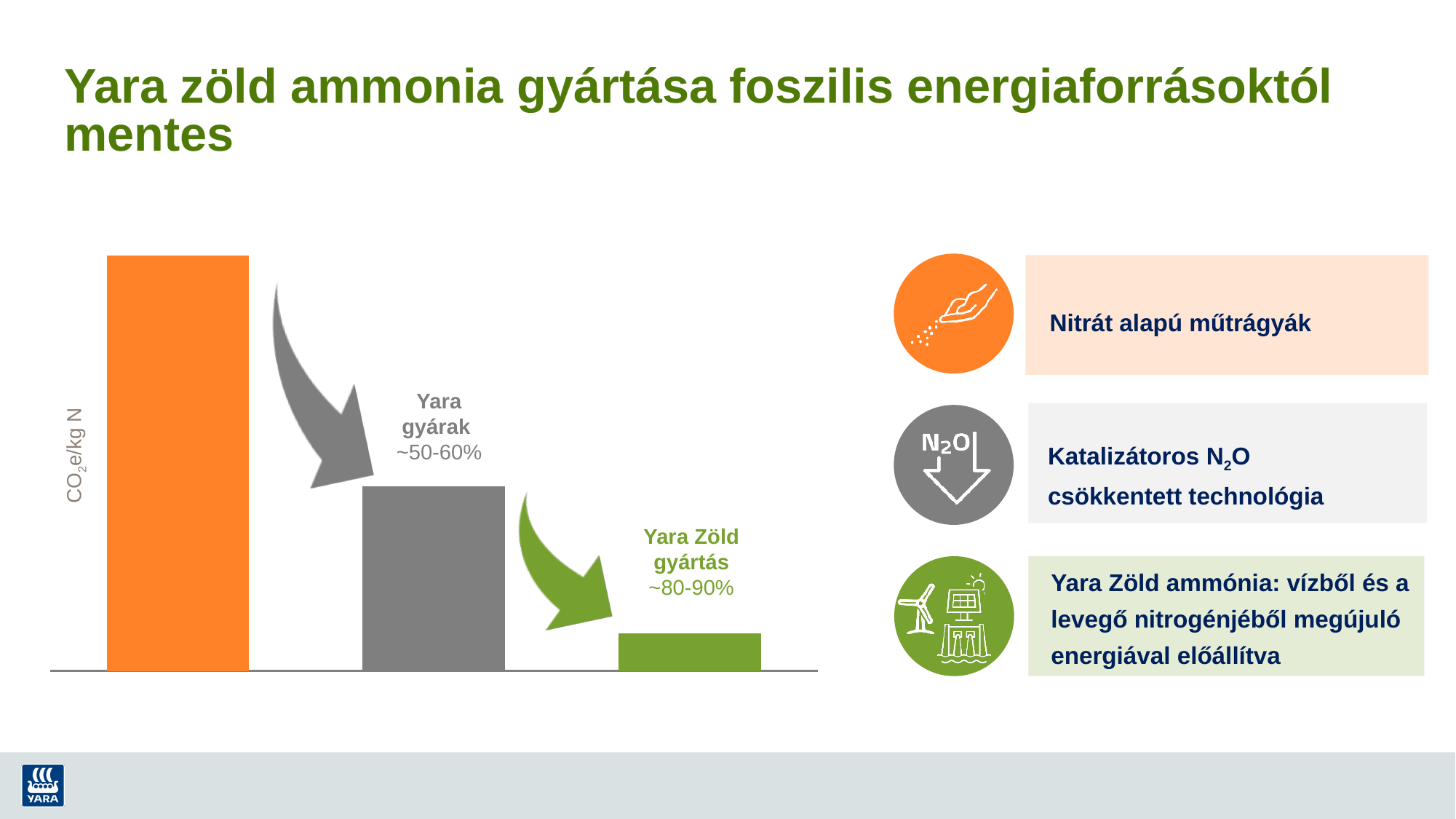
Which labelled category has the lowest bar in the chart? Yara Zöld gyártás Which bar in the chart is the tallest? the orange (leftmost) bar Which bar is taller, Yara gyárak or Yara Zöld gyártás? Yara gyárak What colour is the bar for Yara Zöld gyártás? green What kind of chart is shown on the left of the slide? bar chart Do the bar values rise or fall from left to right across the chart? fall What reduction label is printed next to the Yara Zöld gyártás bar? ~80-90% How many bars does the chart show? 3 What reduction label is printed next to the Yara gyárak bar? ~50-60% What is the label on the vertical axis of the chart? CO2e/kg N